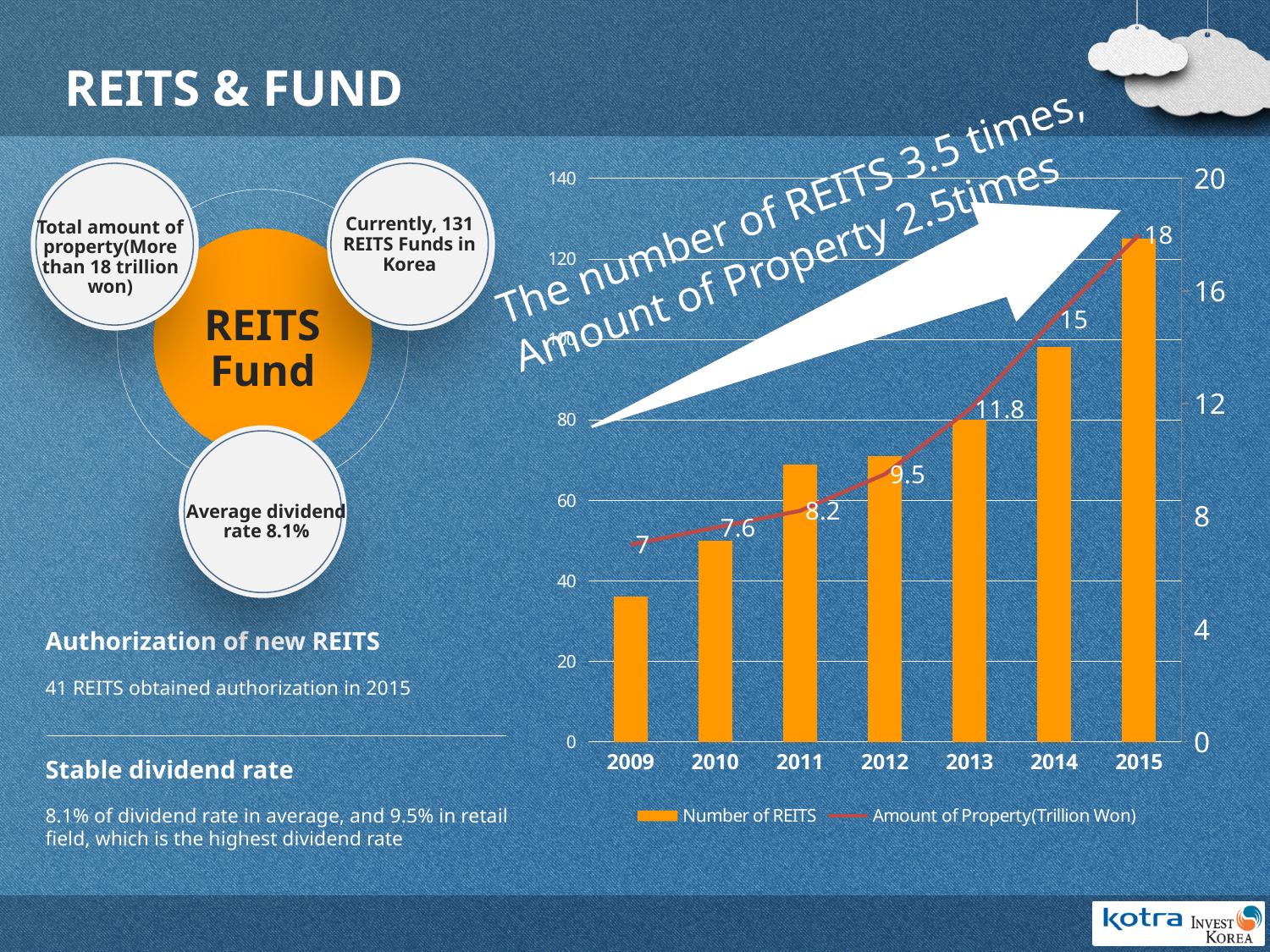
Is the Number of REITS in 2009 greater or less than 40? less What is the difference in Amount of Property between 2014 and 2013? 3.2 Which year has the highest Amount of Property? 2015 Is the Number of REITS in 2015 greater or less than 120? greater What is the Amount of Property (Trillion Won) for 2015? 18 What is the Amount of Property (Trillion Won) for 2011? 8.2 What is the Amount of Property (Trillion Won) for 2013? 11.8 By how much did the Amount of Property increase from 2009 to 2015? 11 Which year has the lowest Number of REITS? 2009 How many series does the chart legend list? 2 How many years are shown on the x axis of the chart? 7 Does the Amount of Property rise or fall from 2009 to 2015? rise